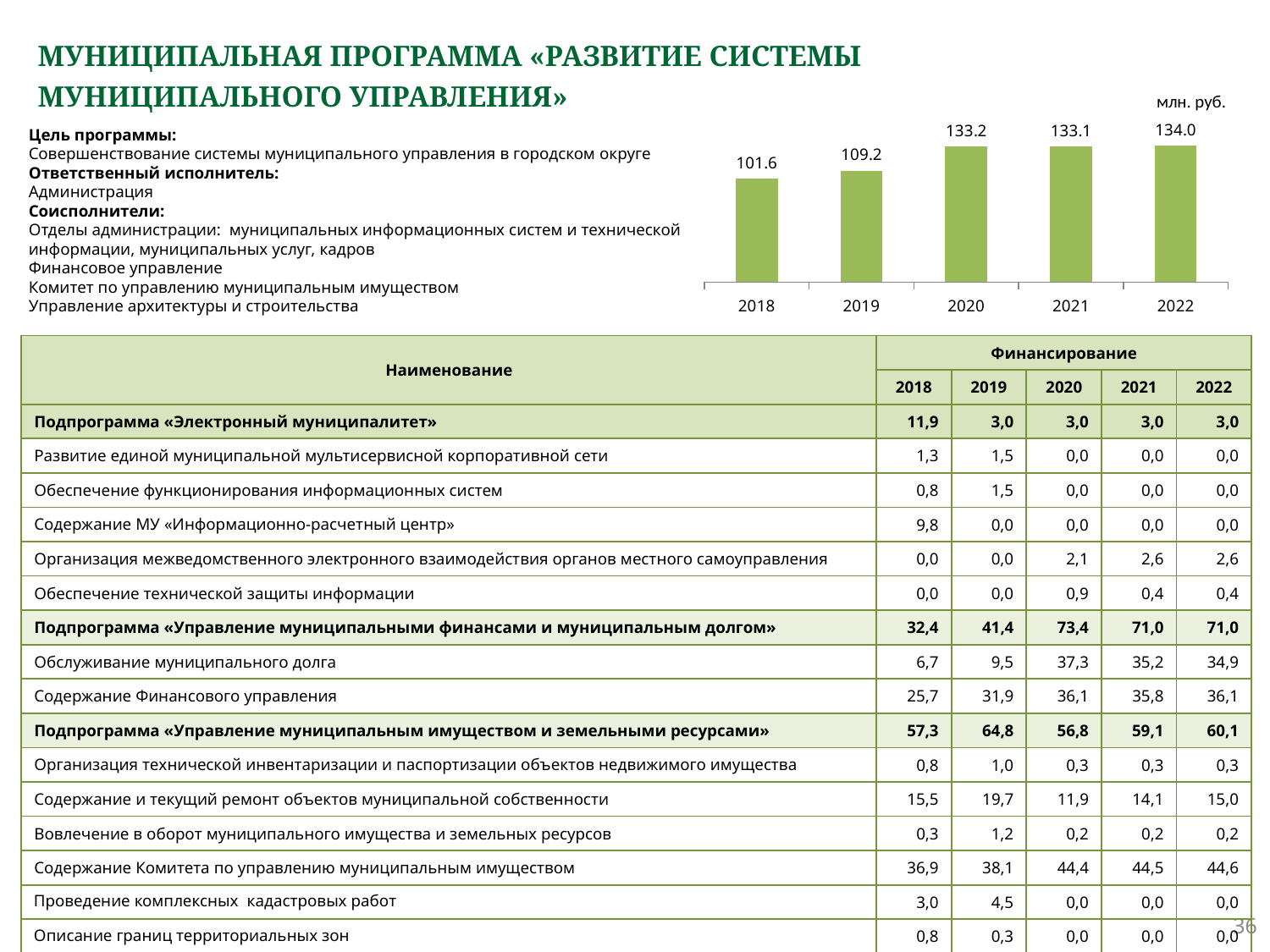
Which year has the highest value in the bar chart? 2022 Do the values in the bar chart generally rise or fall from 2018 to 2022? rise Which year has the lowest value in the bar chart? 2018 What is the difference between the values for 2019 and 2018 in the bar chart? 7.6 What is the value shown for 2020 in the bar chart? 133.2 What is the value shown for 2018 in the bar chart? 101.6 What kind of chart is shown on the slide? bar chart How many years are plotted in the bar chart? 5 What is the value shown for 2022 in the bar chart? 134.0 What is the difference between the values for 2022 and 2018 in the bar chart? 32.4 Which is larger in the bar chart, the value for 2020 or the value for 2019? 2020 What unit is indicated for the values in the bar chart? млн. руб.